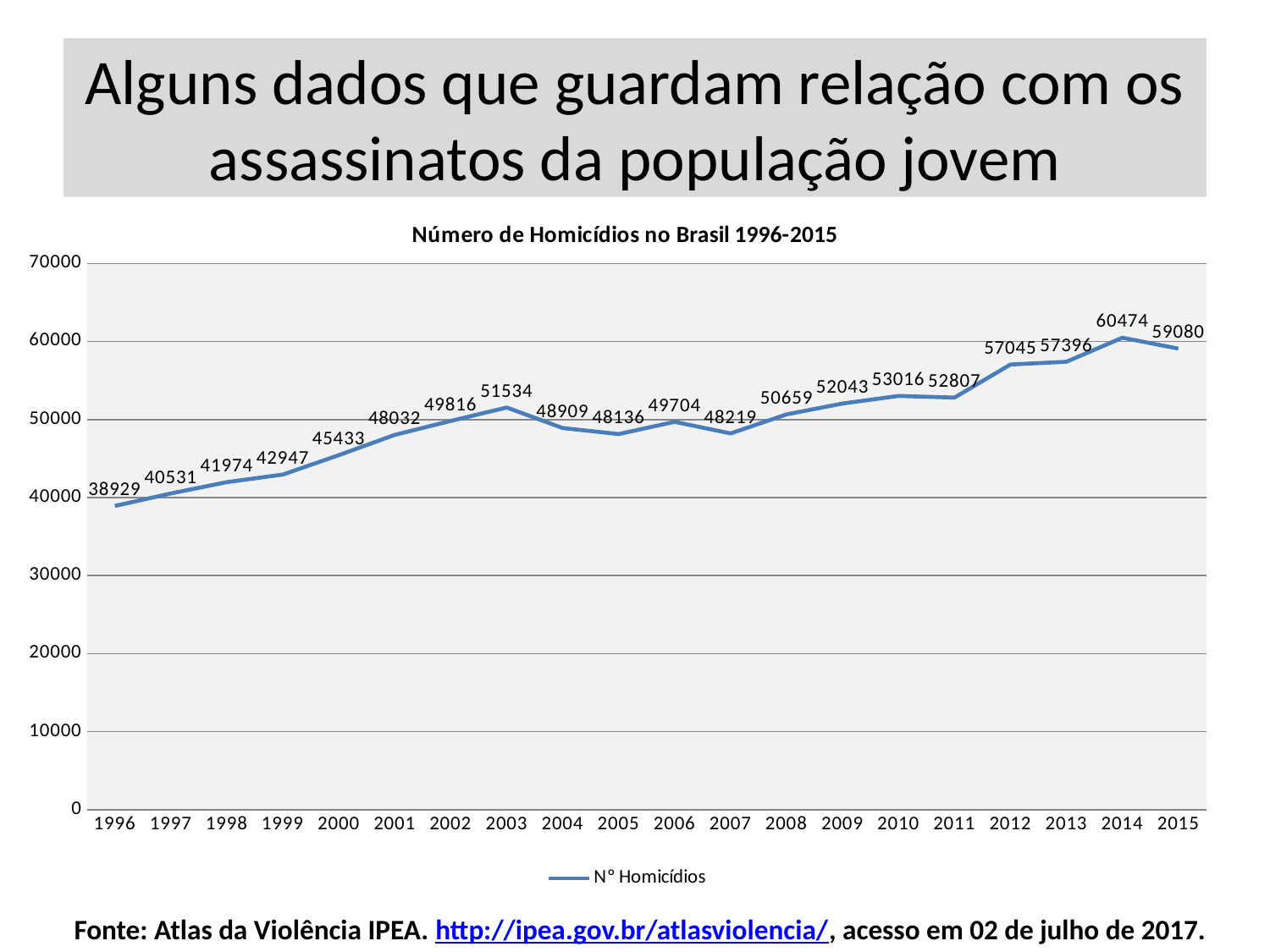
What is the difference between the number of homicides in 2014 and in 2015? 1394 Which year has the lowest number of homicides? 1996 What is the number of homicides shown for 2015? 59080 How many years are plotted on the chart? 20 What is the number of homicides shown for 2003? 51534 Which year has more homicides, 2004 or 2007? 2004 How many series does the legend list? 1 Which year has the highest number of homicides? 2014 What is the number of homicides shown for 1996? 38929 What is the title of the chart? Número de Homicídios no Brasil 1996-2015 What type of chart is shown on the slide? Line chart Overall, do the values rise or fall from 1996 to 2015? Rise